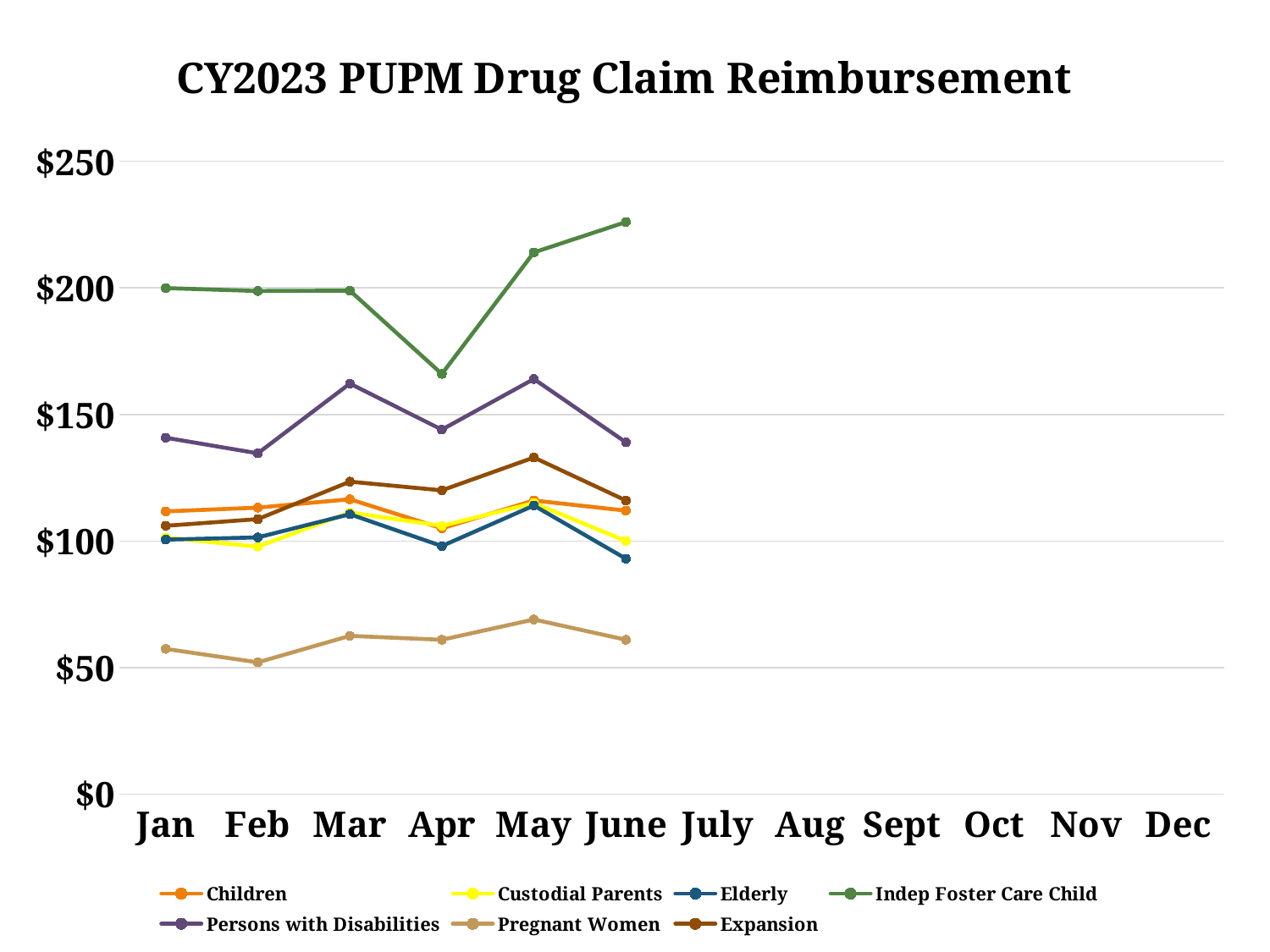
Is the value for Indep Foster Care Child in June greater or less than $200? greater Does the Indep Foster Care Child line rise or fall from Apr to June? rise Is the value for Pregnant Women in Feb greater or less than $50? greater What kind of chart is shown on the slide? line chart How many months have plotted data points? 6 What is the title of the chart? CY2023 PUPM Drug Claim Reimbursement Which is larger in Apr: the value for Expansion or the value for Children? Expansion Is the value for Elderly in June greater or less than $100? less Which series has the lowest value in May? Pregnant Women Which series has the highest value in June? Indep Foster Care Child How many series does the legend list? 7